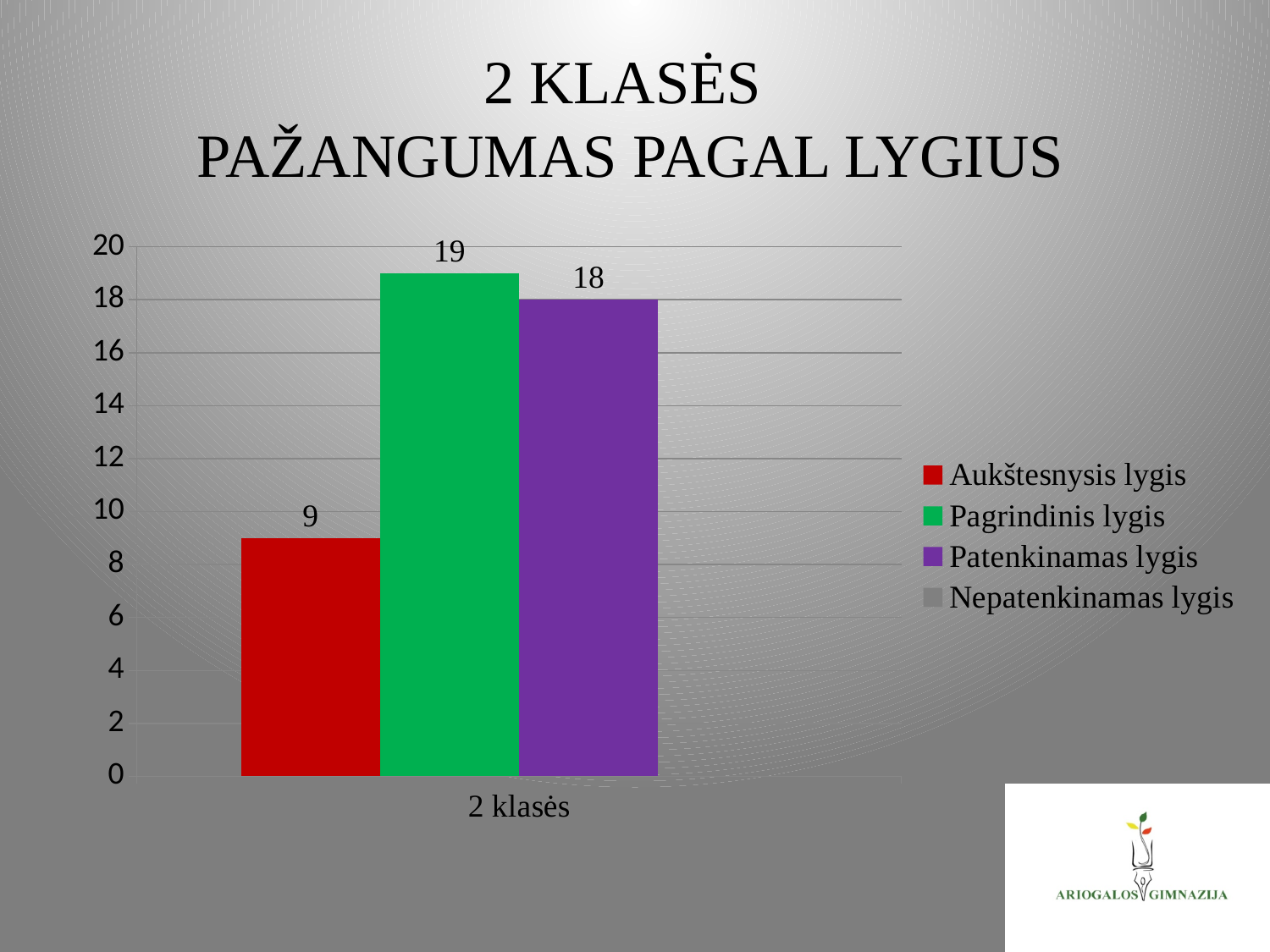
What is the category label shown on the x axis? 2 klasės What kind of chart is shown on the slide? bar chart What is the value for Patenkinamas lygis? 18 Is the value for Aukštesnysis lygis greater or less than 10? less What is the difference between the values for Pagrindinis lygis and Patenkinamas lygis? 1 How many series does the legend list? 4 Which of the plotted series has the lowest value? Aukštesnysis lygis What is the value for Aukštesnysis lygis? 9 What is the difference between the values for Pagrindinis lygis and Aukštesnysis lygis? 10 What is the value for Pagrindinis lygis? 19 Which is larger, the value for Patenkinamas lygis or the value for Aukštesnysis lygis? Patenkinamas lygis Which series has the highest value? Pagrindinis lygis